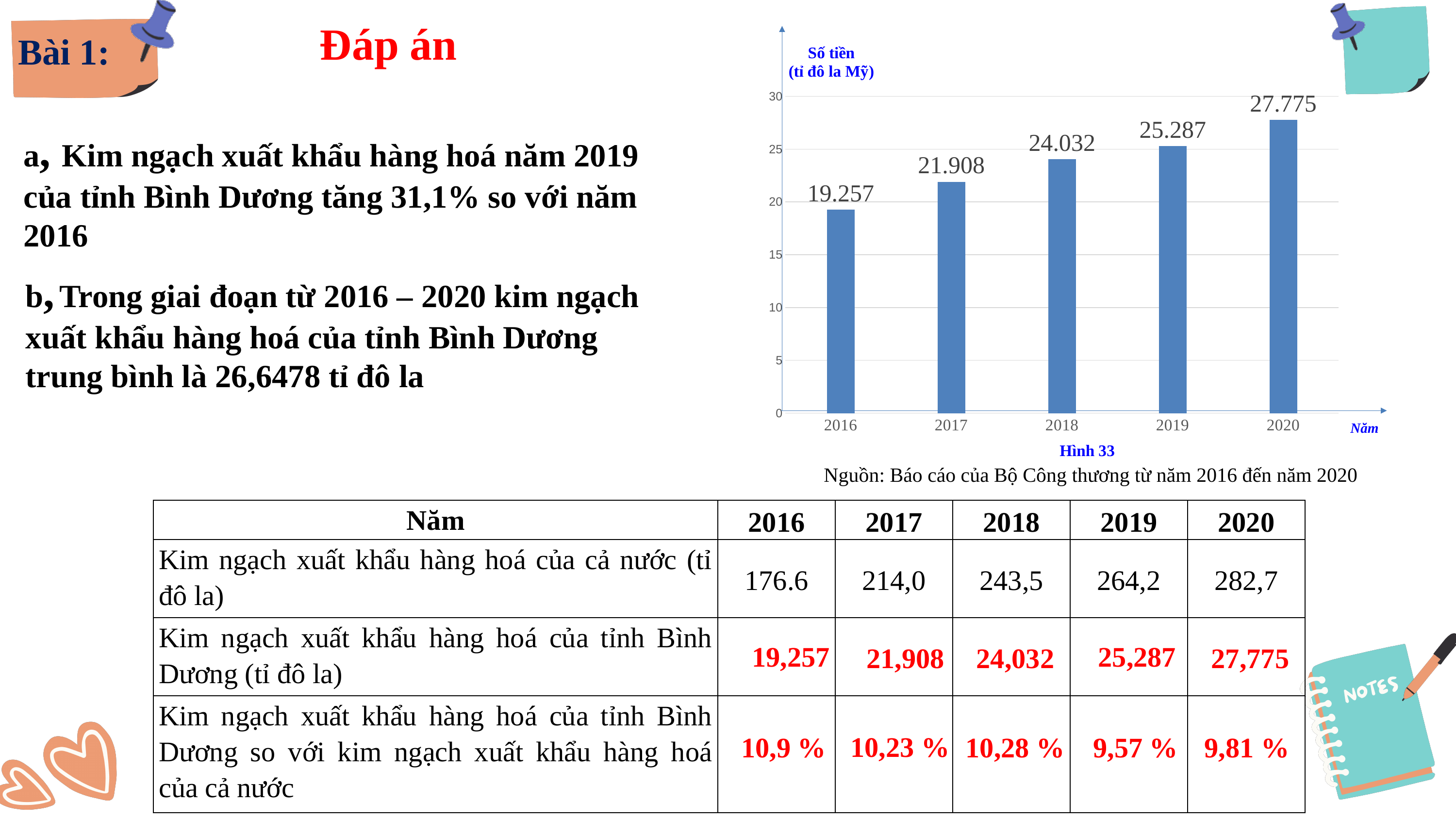
What is the value shown for 2018 in the bar chart? 24.032 Which is larger in the bar chart, the value for 2017 or the value for 2019? 2019 What is the difference between the values for 2020 and 2016 in the bar chart? 8.518 Do the bar values rise or fall from 2016 to 2020? rise Which year has the lowest bar in the chart? 2016 Is the value for 2017 in the bar chart greater or less than 20? greater What is the difference between the values for 2019 and 2018 in the bar chart? 1.255 How many years are shown on the x axis of the bar chart? 5 Which year has the highest bar in the chart? 2020 What is the value shown for 2016 in the bar chart? 19.257 What type of chart is shown on the slide? bar chart What is the value shown for 2020 in the bar chart? 27.775